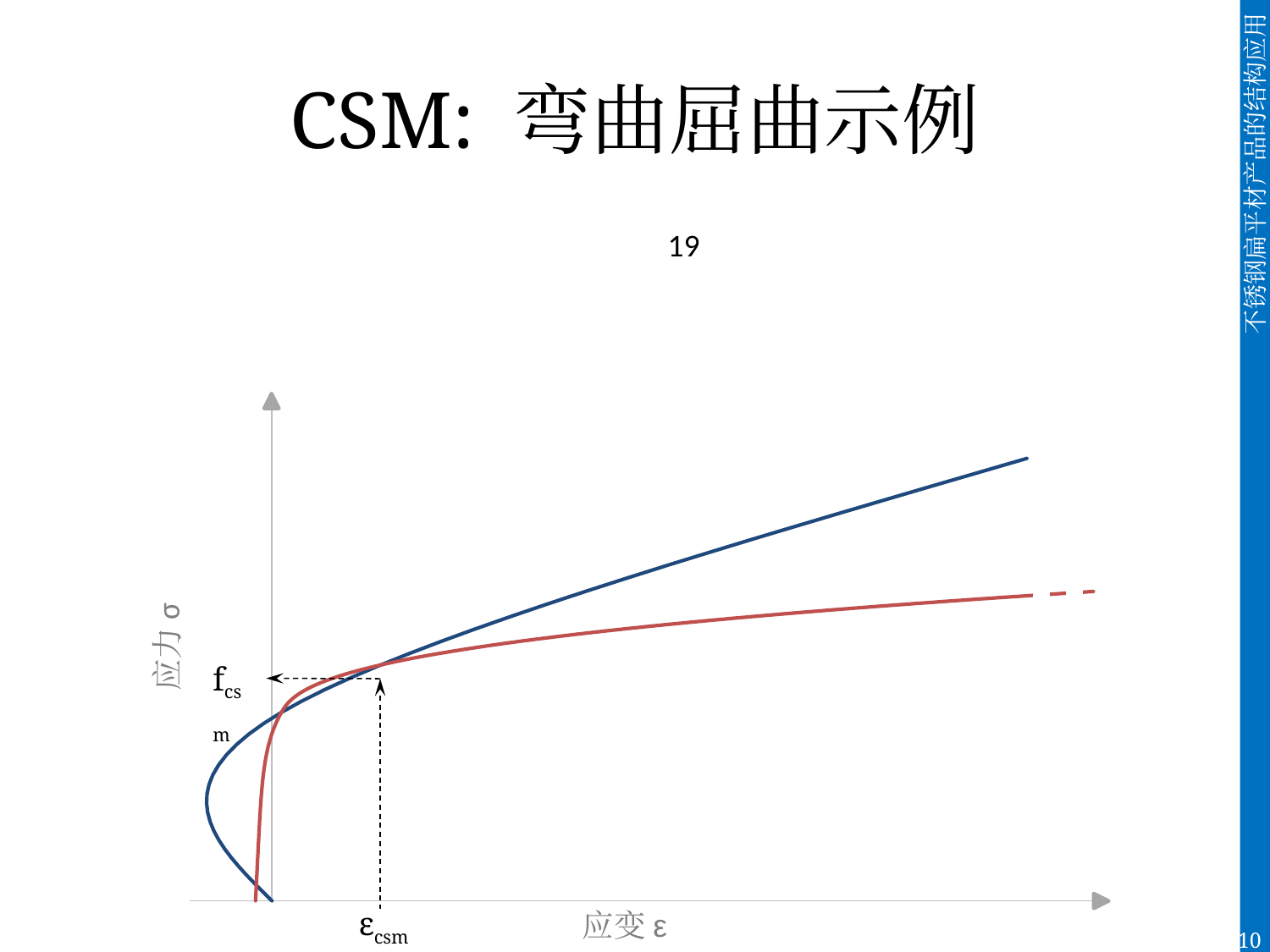
Do the curves rise or fall as strain increases to the right of the point where they cross? rise What is the label of the horizontal axis of the chart? 应变 ε What label is marked on the horizontal axis at the dashed vertical line? εcsm How many curves are plotted on the chart? 2 What label is marked on the vertical axis at the dashed horizontal line? fcsm At large strain values on the right side of the chart, which curve is higher, the blue one or the red one? the blue one What kind of chart is shown on the slide? line chart What is the label of the vertical axis of the chart? 应力 σ